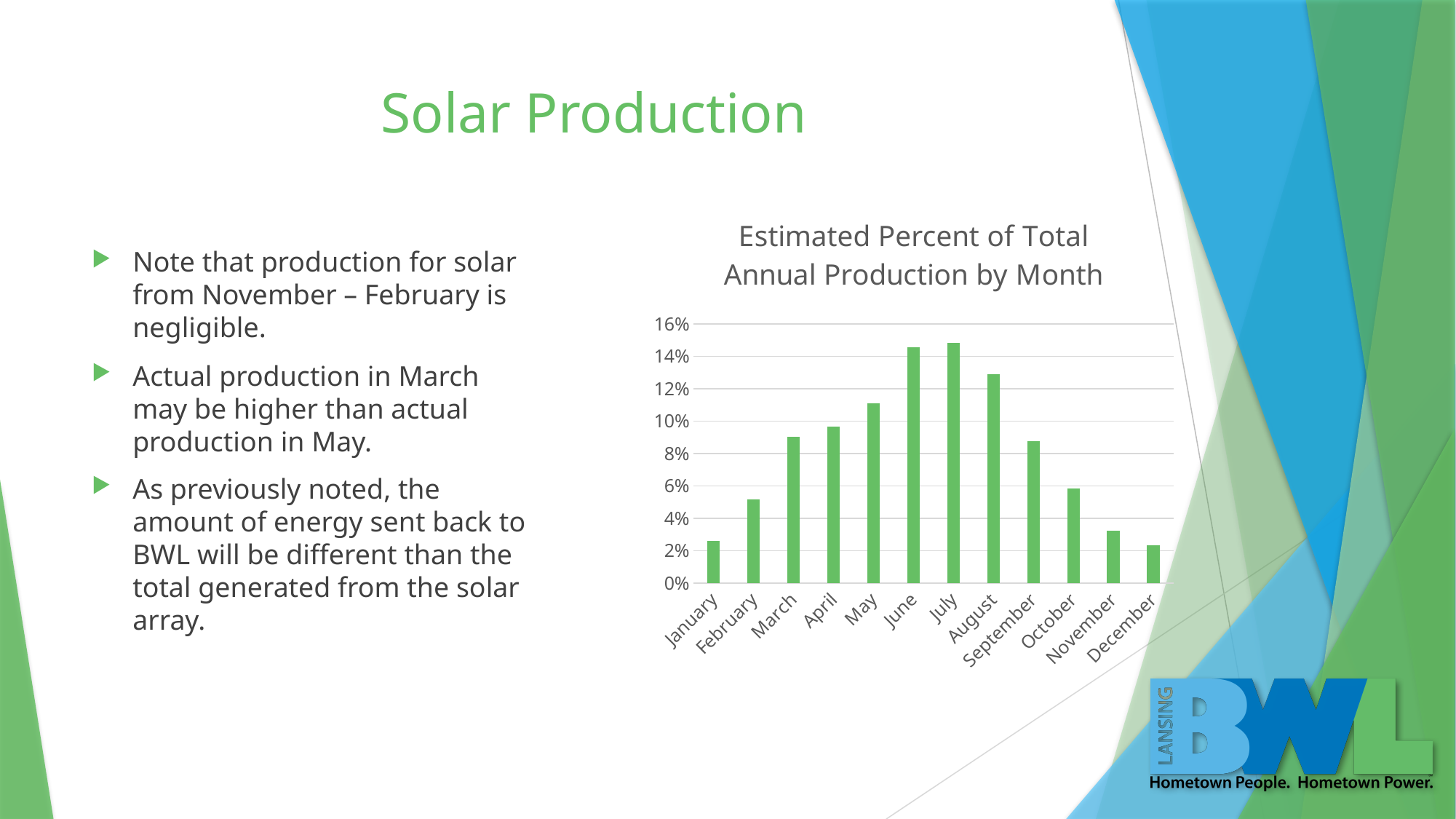
What is the title of the chart? Estimated Percent of Total Annual Production by Month Is the value for March greater or less than 10%? less Which is larger, the value for June or the value for August? June Which is larger, the value for February or the value for September? September Is the value for May greater or less than 10%? greater Do the values rise or fall from January to July? rise Is the value for August greater or less than 12%? greater Do the values rise or fall from July to December? fall How many months are plotted on the chart? 12 What kind of chart is shown on the slide? bar chart